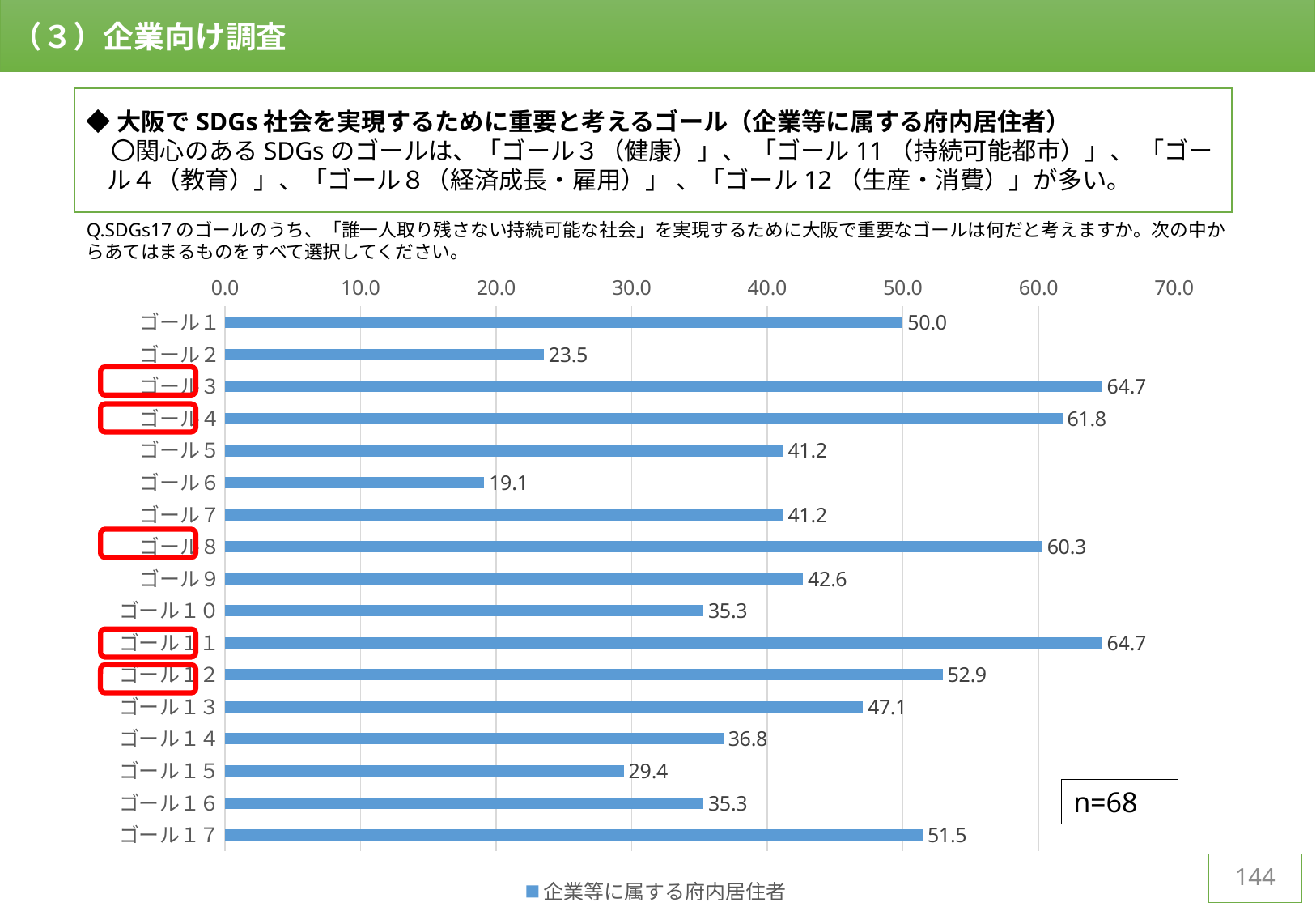
What is the value for ゴール１２ in the chart? 52.9 What is the value for ゴール１ in the chart? 50.0 Which has a larger value, ゴール１３ or ゴール１５? ゴール１３ What kind of chart is shown on the slide? Bar chart What is the difference between the values for ゴール３ and ゴール４? 2.9 Which has a larger value, ゴール９ or ゴール１０? ゴール９ What is the value for ゴール８ in the chart? 60.3 What is the sample size (n) shown on the chart? n=68 Which goal has the lowest value in the chart? ゴール６ How many goals (categories) are shown in the chart? 17 What is the value for ゴール１７ in the chart? 51.5 What is the difference between the values for ゴール１ and ゴール２? 26.5